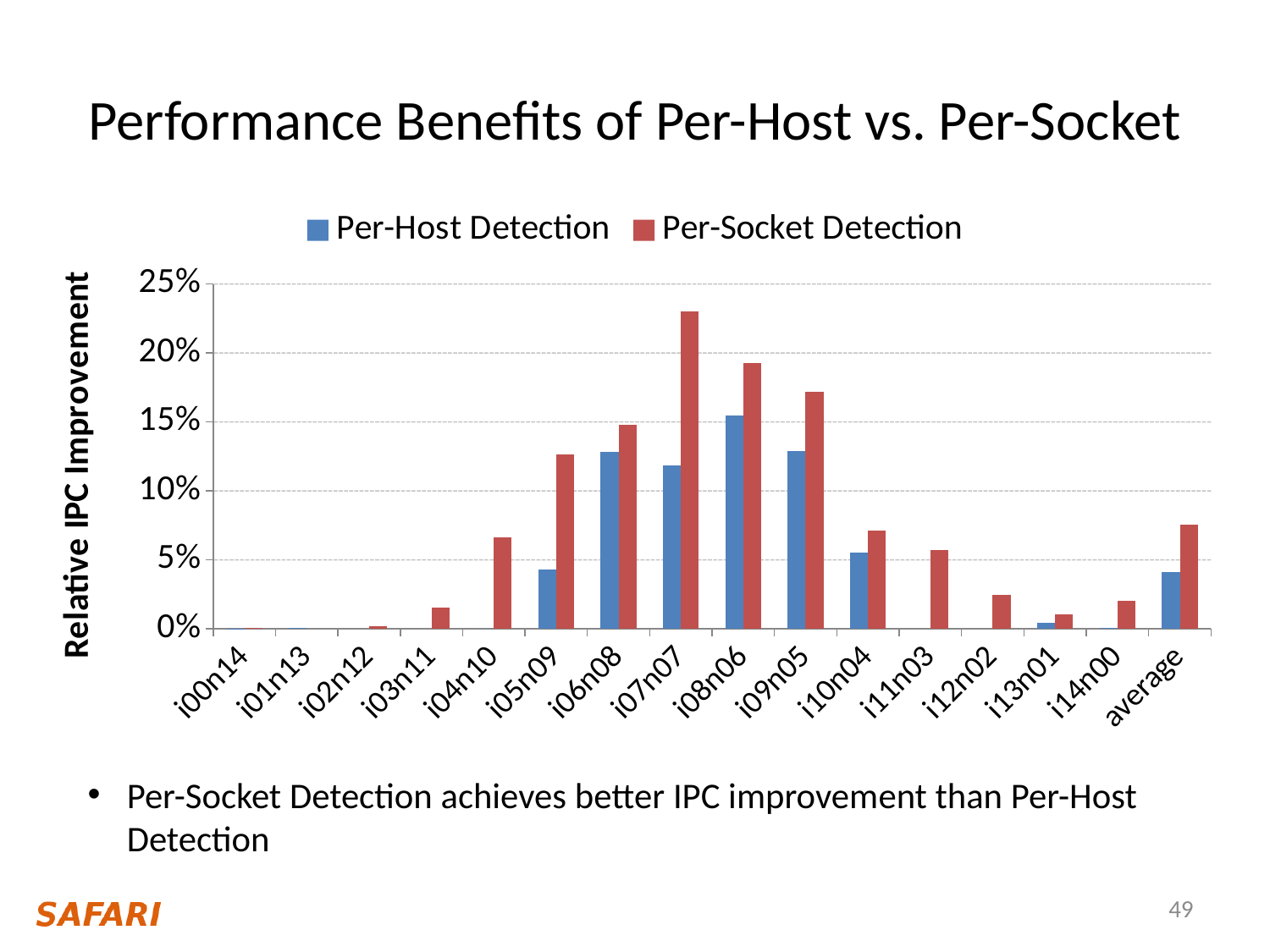
How many series does the legend list? 2 Is the Per-Host Detection value for i05n09 greater or less than 5%? less What kind of chart is shown on the slide? bar chart Is the Per-Socket Detection value for average greater or less than 5%? greater What is the label of the y axis? Relative IPC Improvement How many categories are shown on the x axis? 16 Which category has the highest Per-Socket Detection value? i07n07 Is the Per-Socket Detection value for i12n02 greater or less than 5%? less For i09n05, which is larger: Per-Host Detection or Per-Socket Detection? Per-Socket Detection Which category has the highest Per-Host Detection value? i08n06